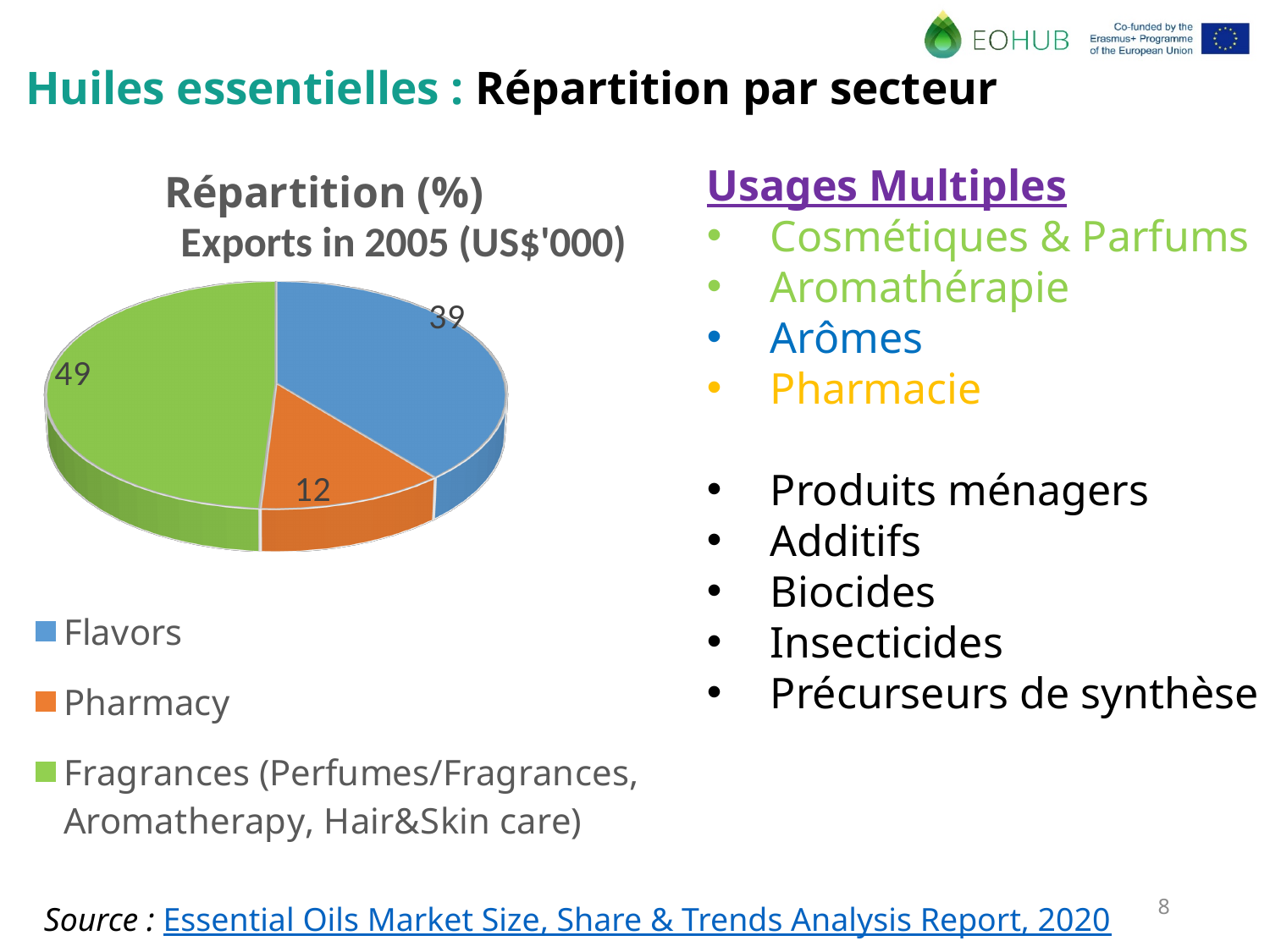
What is the title of the pie chart? Répartition (%) What kind of chart is shown on the slide? pie chart How many categories does the pie chart show? 3 What colour is the Pharmacy slice in the pie chart? orange What is the difference between the values for Fragrances and Flavors? 10 What is the value for Flavors in the pie chart? 39 Which category has the smallest slice of the pie chart? Pharmacy Which is larger, the value for Flavors or the value for Pharmacy? Flavors What is the value for Fragrances (Perfumes/Fragrances, Aromatherapy, Hair&Skin care) in the pie chart? 49 What is the value for Pharmacy in the pie chart? 12 What is the difference between the values for Flavors and Pharmacy? 27 Which category has the largest slice of the pie chart? Fragrances (Perfumes/Fragrances, Aromatherapy, Hair&Skin care)